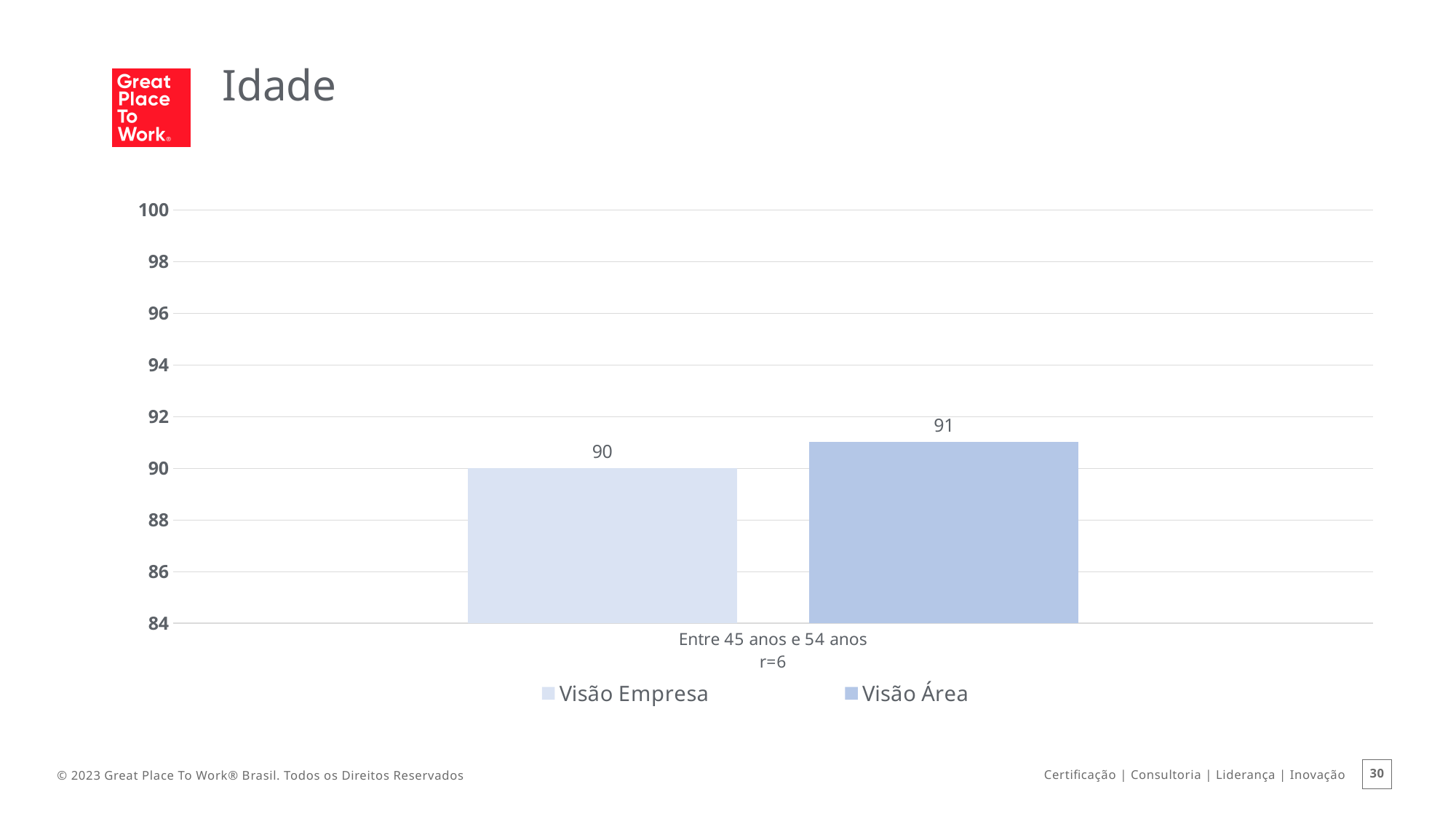
Is the value for Visão Área greater or less than 88? greater What kind of chart is shown on the slide? Bar chart What is the value for Visão Área for the category 'Entre 45 anos e 54 anos'? 91 How many series does the legend list? 2 What is the difference between the Visão Área and Visão Empresa values for 'Entre 45 anos e 54 anos'? 1 Is the value for Visão Empresa greater or less than 92? less Which series has the higher value for 'Entre 45 anos e 54 anos', Visão Empresa or Visão Área? Visão Área What is the lowest value shown on the y axis? 84 What is the title of the slide? Idade How many categories are shown on the x axis of the chart? 1 What is the value for Visão Empresa for the category 'Entre 45 anos e 54 anos'? 90 What is the sample size (r) shown under the category label? r=6